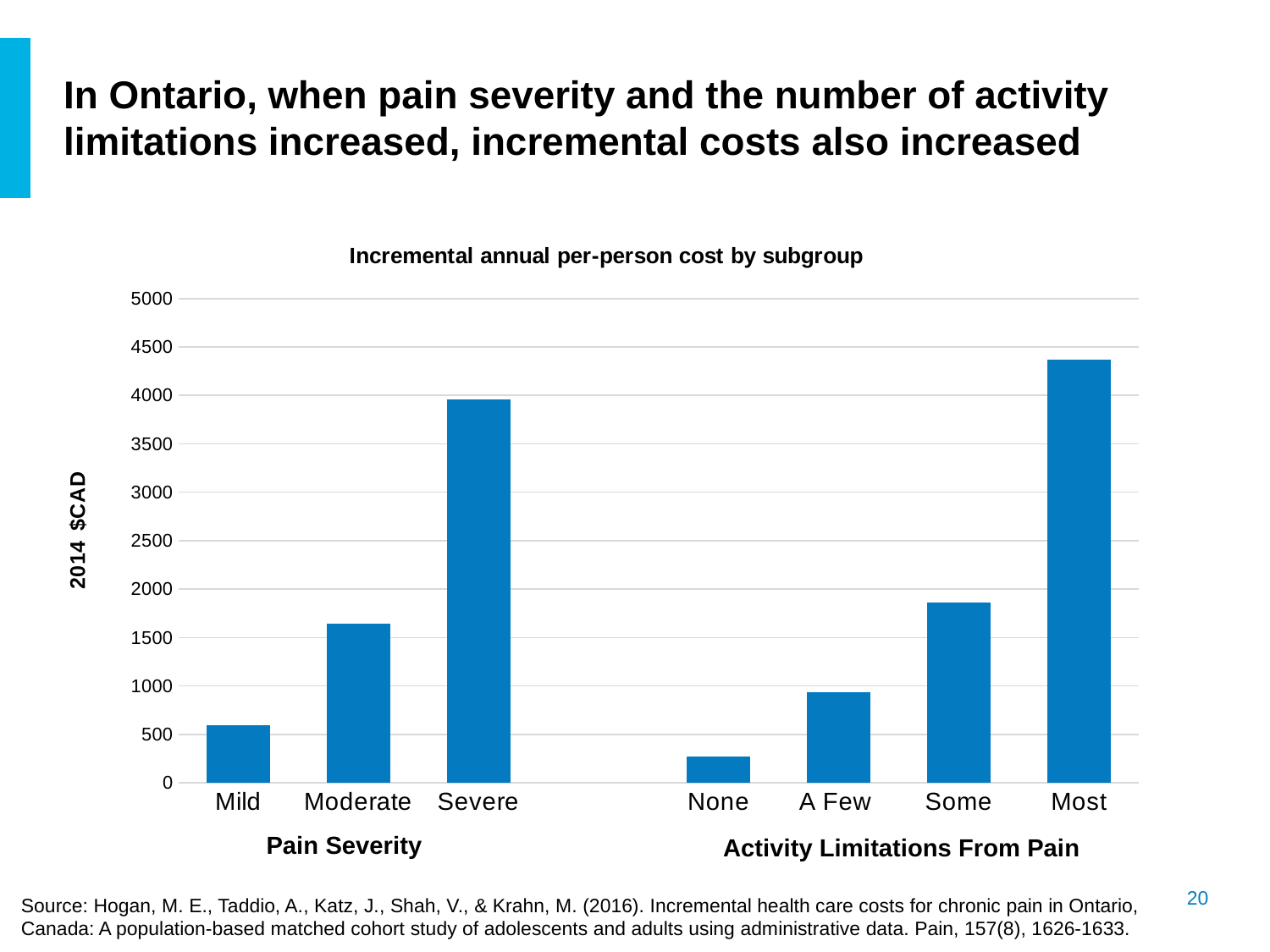
Which category has the highest incremental annual per-person cost? Most What kind of chart is shown on the slide? Bar chart Do the values rise or fall from None to Most along the Activity Limitations From Pain axis? Rise Which is larger, the value for Moderate or the value for Some? Some Is the value for Mild greater or less than 1000? less Within the Pain Severity group, which category has the highest cost? Severe Is the value for Severe greater or less than 3500? greater What is the label on the vertical axis of the chart? 2014 $CAD Is the value for Most greater or less than 4000? greater Which category has the lowest incremental annual per-person cost? None What is the title of the chart? Incremental annual per-person cost by subgroup How many bars are plotted in the chart? 7